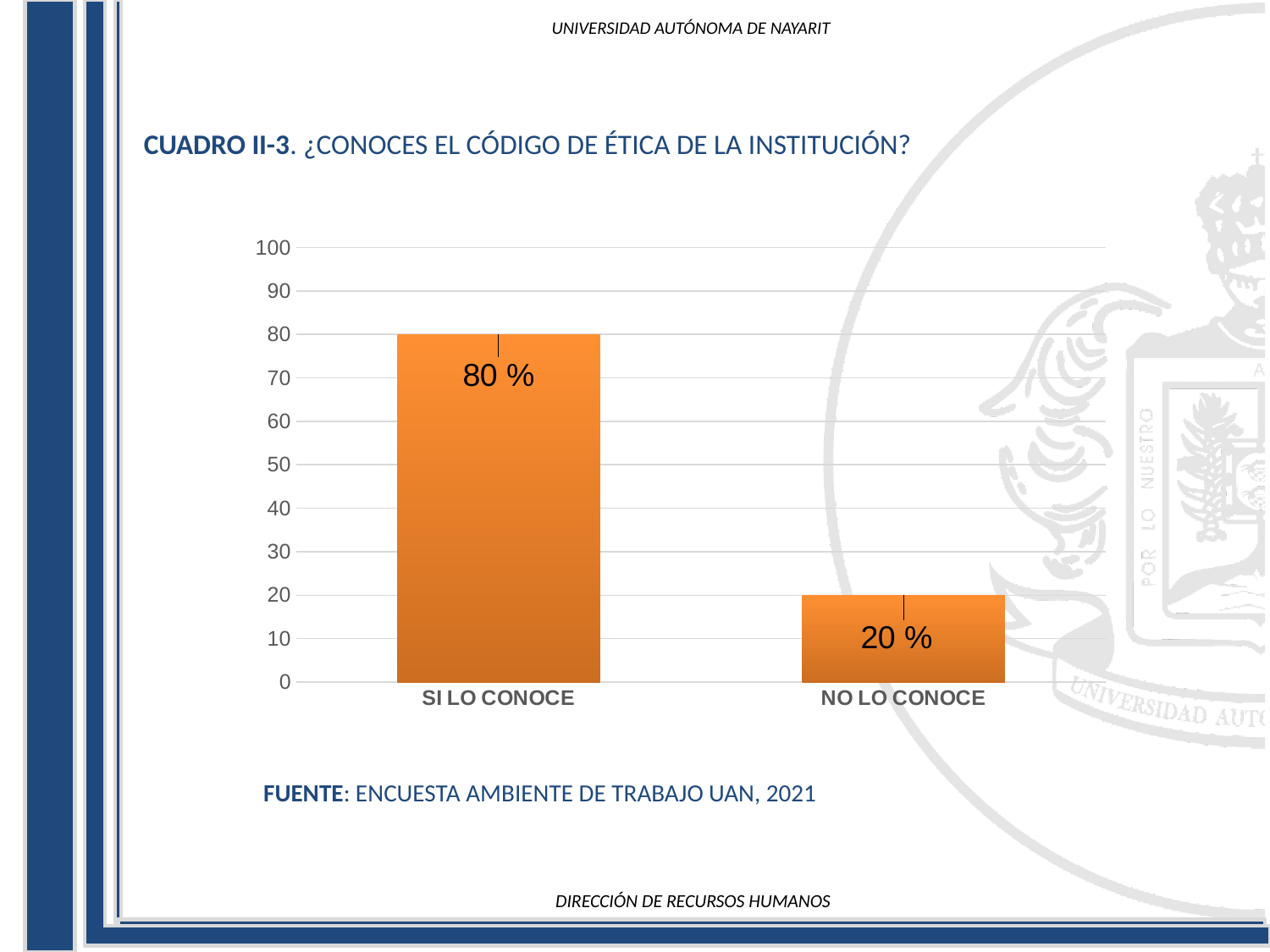
Which category has the highest value? SI LO CONOCE How many categories are shown on the x axis? 2 Which is larger, the value for SI LO CONOCE or the value for NO LO CONOCE? SI LO CONOCE What is the maximum value shown on the vertical axis? 100 Is the value for NO LO CONOCE greater or less than 30? less What colour are the bars in the chart? orange Is the value for SI LO CONOCE greater or less than 50? greater What kind of chart is shown on the slide? bar chart What is the difference between the values for SI LO CONOCE and NO LO CONOCE? 60 % What is the value for NO LO CONOCE? 20 % Which category has the lowest value? NO LO CONOCE What is the value for SI LO CONOCE? 80 %